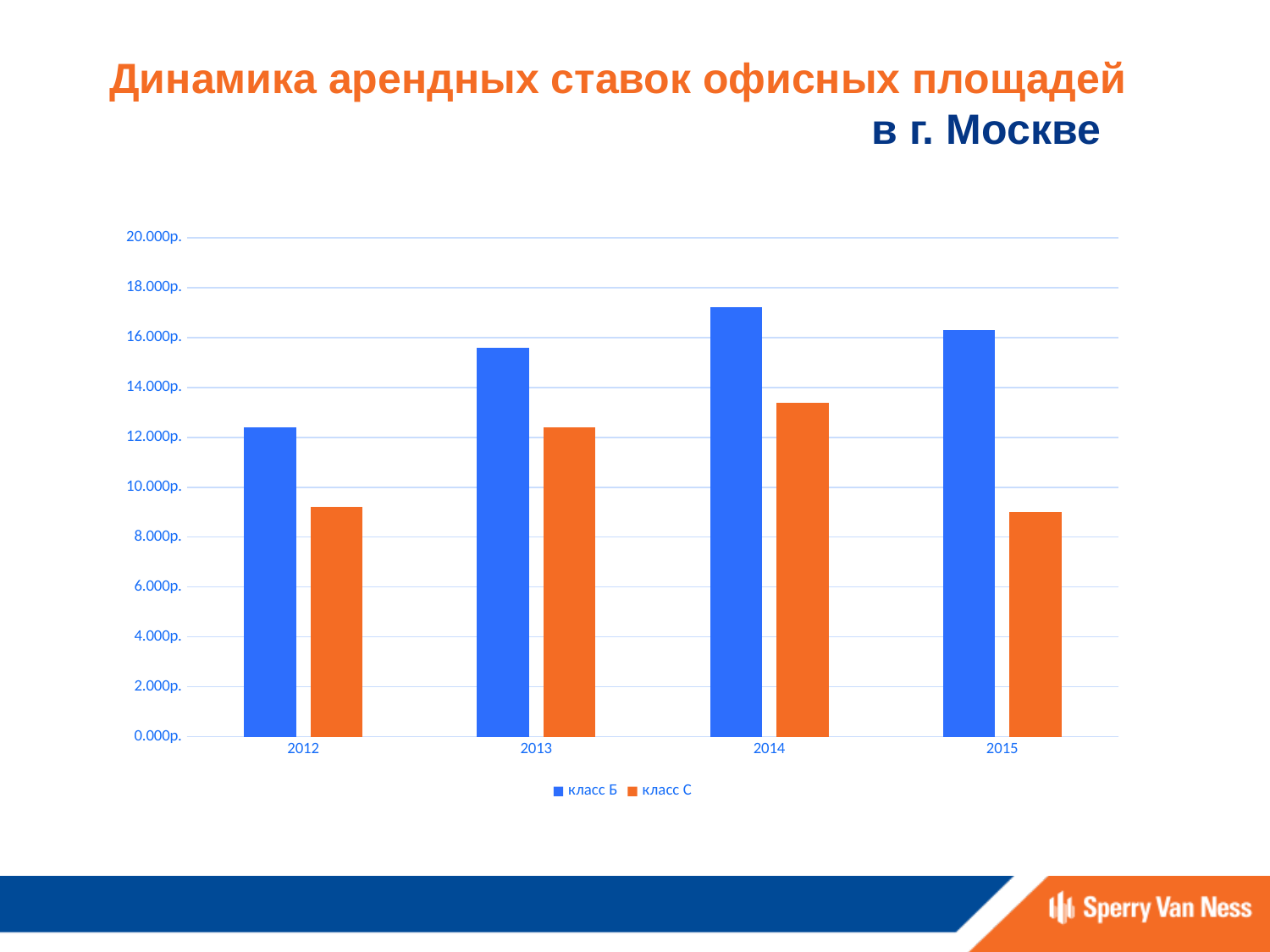
In 2013, which series has the larger value, класс Б or класс С? класс Б Which year has the highest value for класс Б? 2014 How many series does the chart legend list? 2 Is the value for класс Б in 2013 greater or less than 14.000р.? greater Is the value for класс С in 2012 greater or less than 10.000р.? less Does the value for класс Б rise or fall from 2012 to 2014? rise What kind of chart is shown on the slide? bar chart What are the two series named in the legend? класс Б and класс С Which year has the highest value for класс С? 2014 Is the value for класс Б in 2014 greater or less than 16.000р.? greater How many years are shown on the x axis of the chart? 4 Which year has the lowest value for класс Б? 2012